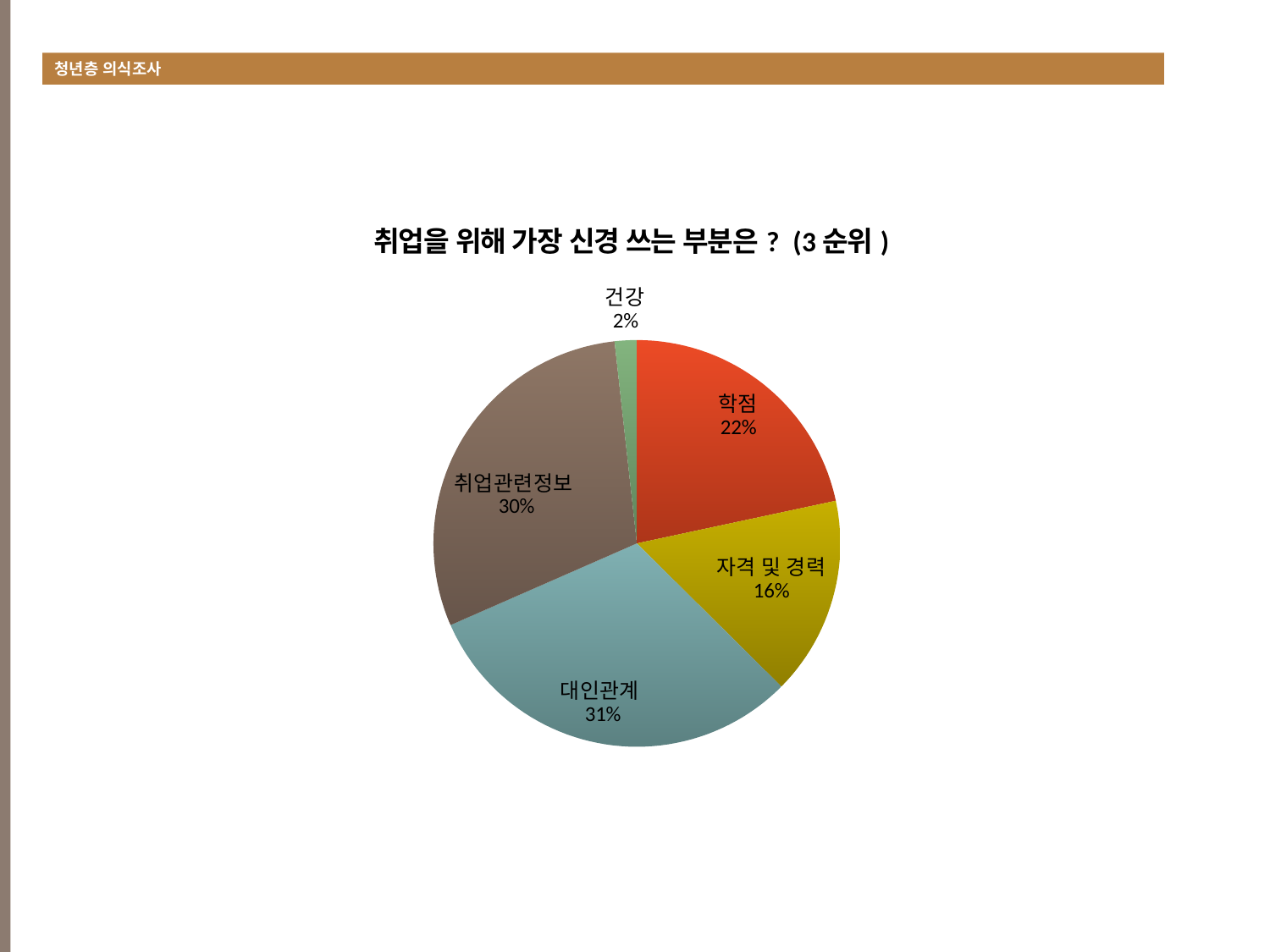
Which category has the smallest slice of the pie? 건강 What share of the pie does 취업관련정보 represent? 30% What is the title of the chart? 취업을 위해 가장 신경 쓰는 부분은 ? (3 순위 ) How many categories are shown in the pie chart? 5 Which is larger, the share for 학점 or the share for 자격 및 경력? 학점 What is the difference between the shares of 대인관계 and 건강? 29% What is the difference between the shares of 학점 and 자격 및 경력? 6% What kind of chart is shown on the slide? Pie chart What is the value shown for 자격 및 경력? 16% What is the value shown for 학점? 22% What is the value shown for 건강? 2% What share of the pie does 대인관계 represent? 31%